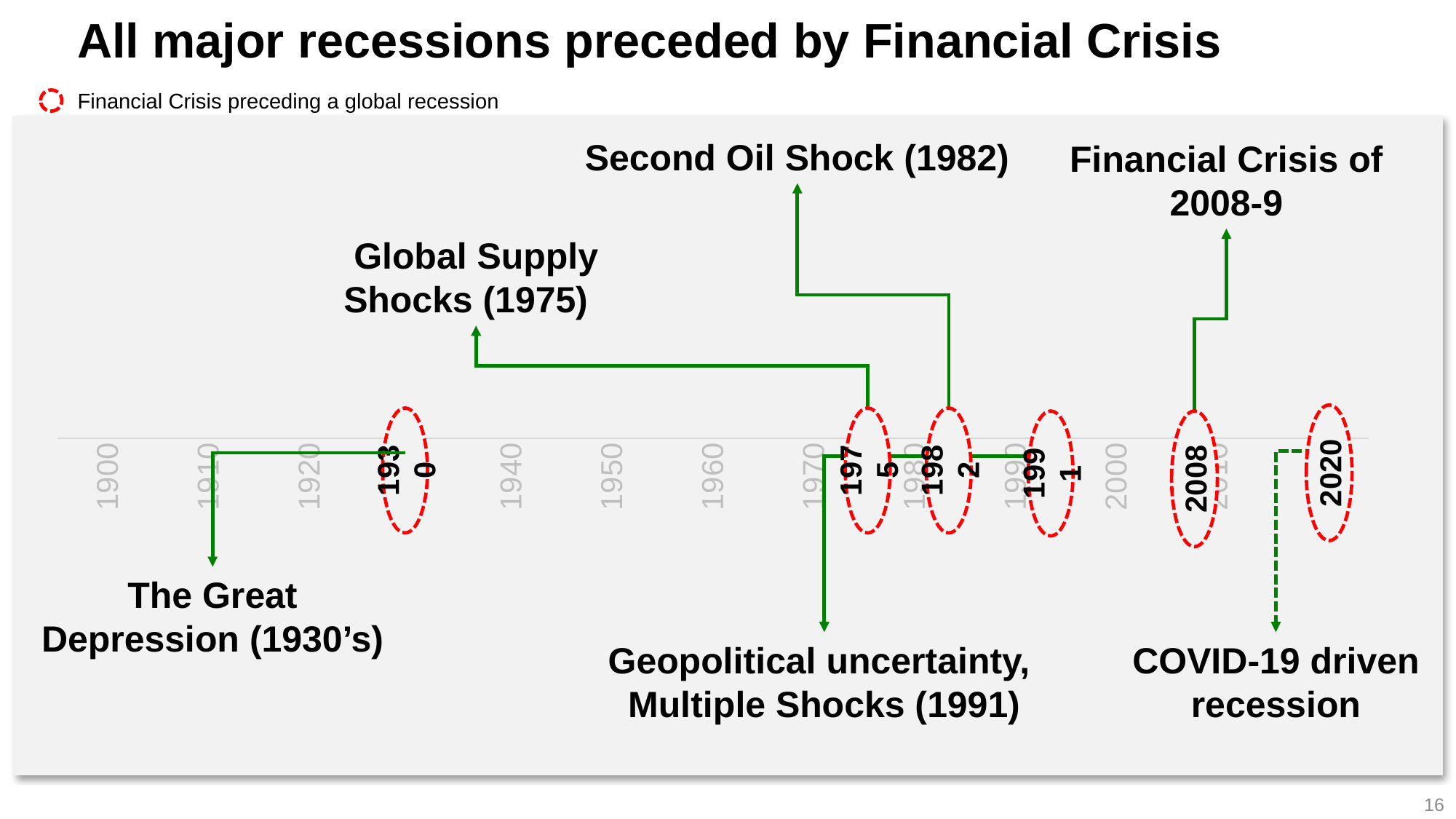
What kind of chart is shown on the slide? A timeline How many years separate the circled years 2008 and 2020? 12 Which event is linked to the year 1982 on the timeline? Second Oil Shock What is the earliest year marked with a dashed red circle on the timeline? 1930 What is the title of the slide? All major recessions preceded by Financial Crisis What is the latest year marked with a dashed red circle on the timeline? 2020 What does the dashed red circle in the legend represent? Financial Crisis preceding a global recession Which event is linked to the year 2020 on the timeline? COVID-19 driven recession Which event is linked to the year 1991 on the timeline? Geopolitical uncertainty, Multiple Shocks Which event is linked to the year 1975 on the timeline? Global Supply Shocks How many years are marked with a dashed red circle on the timeline? 6 Which circled year comes earlier on the timeline, 1975 or 1982? 1975